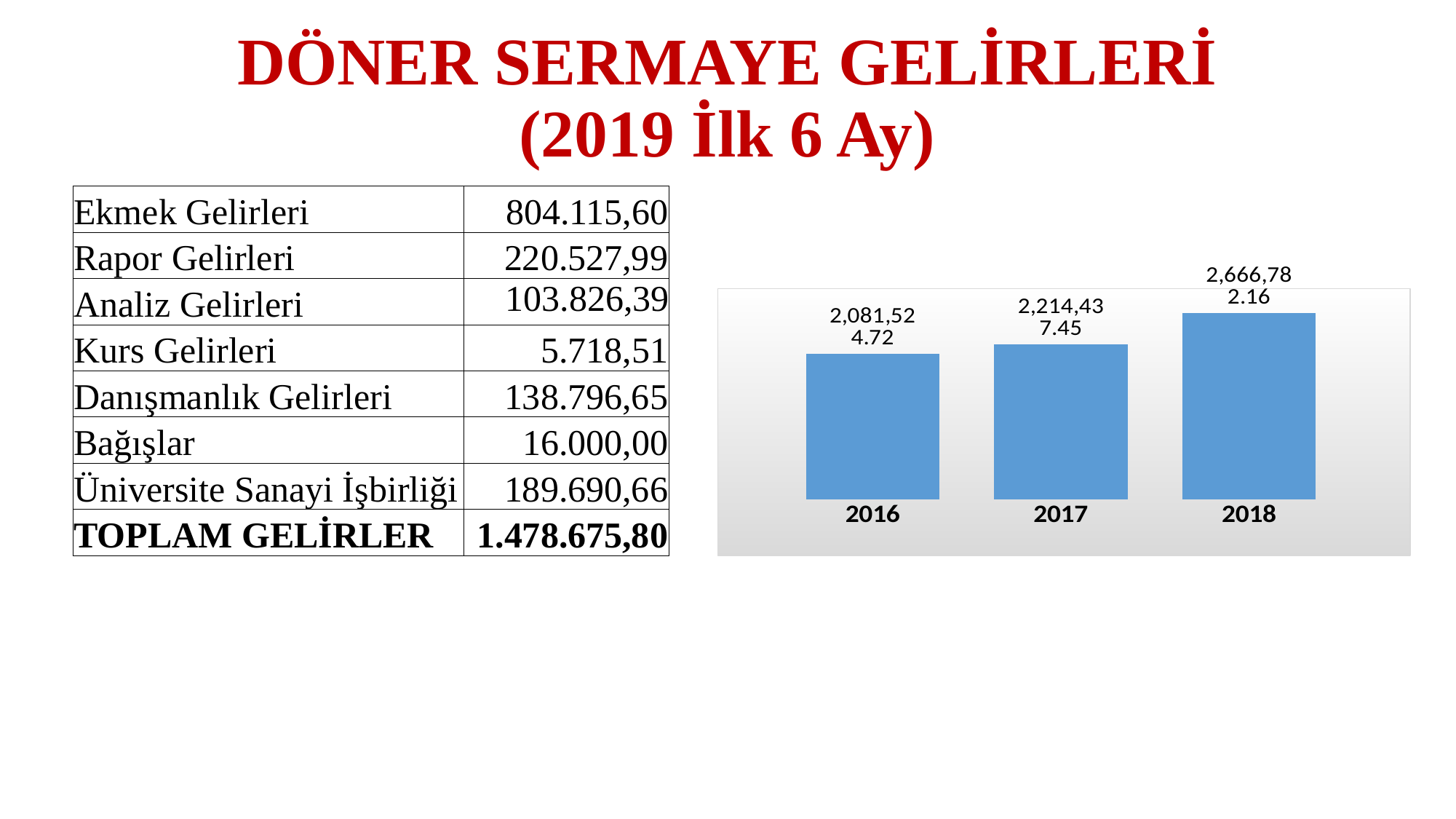
What colour are the bars in the chart? blue What is the value shown for 2017 in the bar chart? 2,214,437.45 Do the values in the bar chart rise or fall from 2016 to 2018? rise In the bar chart, is the value for 2017 larger or smaller than the value for 2018? smaller What type of chart is shown on the right side of the slide? bar chart What is the difference between the 2018 and 2016 values in the bar chart? 585,257.44 Which year has the lowest value in the bar chart? 2016 What is the difference between the 2017 and 2016 values in the bar chart? 132,912.73 What is the value shown for 2016 in the bar chart? 2,081,524.72 Which year has the highest value in the bar chart? 2018 How many bars does the chart on the right show? 3 What is the value shown for 2018 in the bar chart? 2,666,782.16